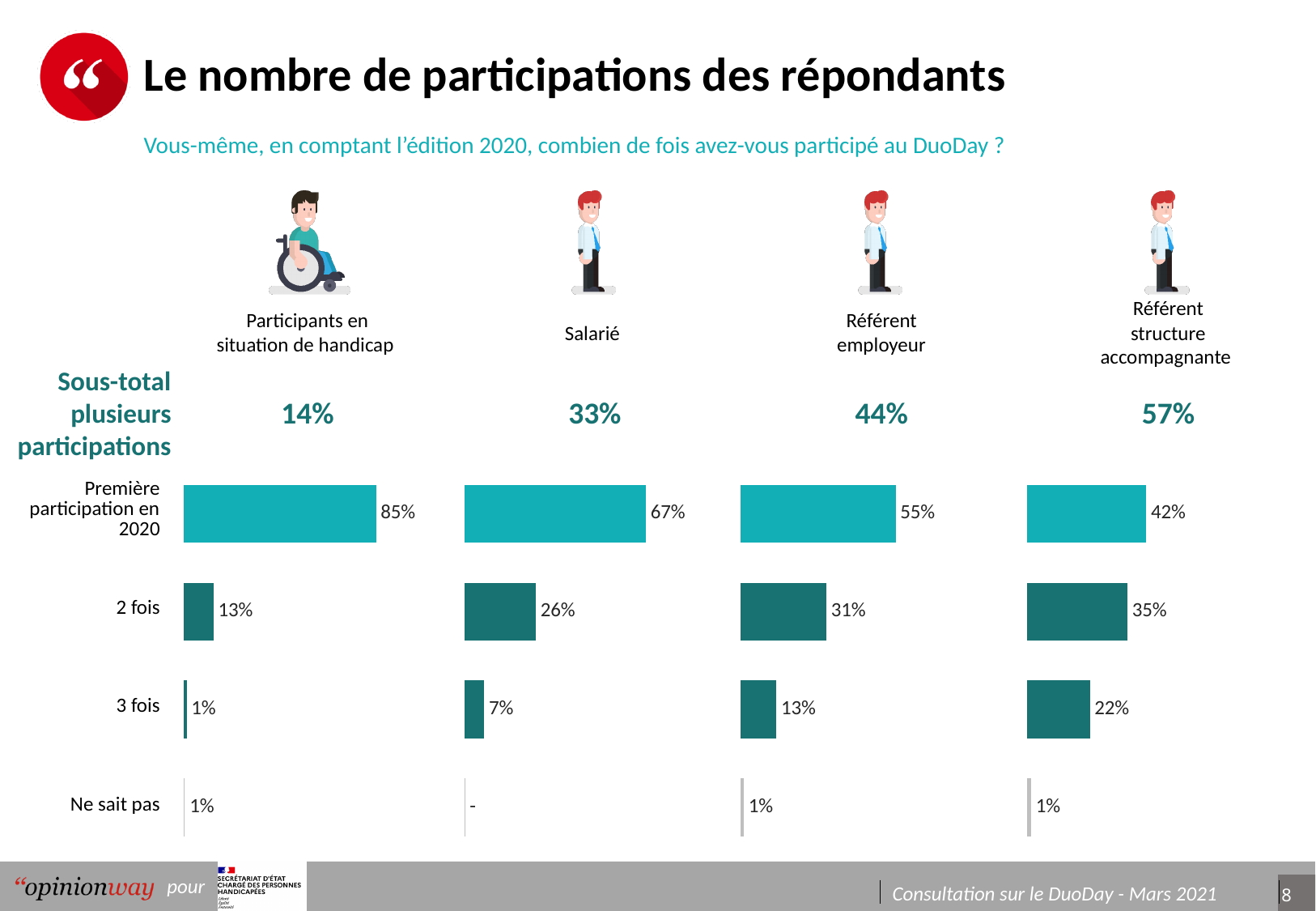
In the chart for Participants en situation de handicap, what is the value for Première participation en 2020? 85% In the chart for Référent structure accompagnante, which category has the highest value? Première participation en 2020 In the chart for Référent employeur, what is the value for 3 fois? 13% In the chart for Salarié, what is the value for 2 fois? 26% In the chart for Référent employeur, what is the difference between Première participation en 2020 and 2 fois? 24 points Which is larger: the value for 2 fois in the Salarié chart or the value for 2 fois in the Référent structure accompagnante chart? Référent structure accompagnante What kind of chart is used to show the participation data for each respondent group? Bar chart How many categories are shown in each of the bar charts? 4 In the chart for Référent structure accompagnante, what is the value for Première participation en 2020? 42% How many respondent groups have their own bar chart on the slide? 4 In the chart for Salarié, which category has the lowest value? Ne sait pas What is the Sous-total plusieurs participations value shown for Référent employeur? 44%